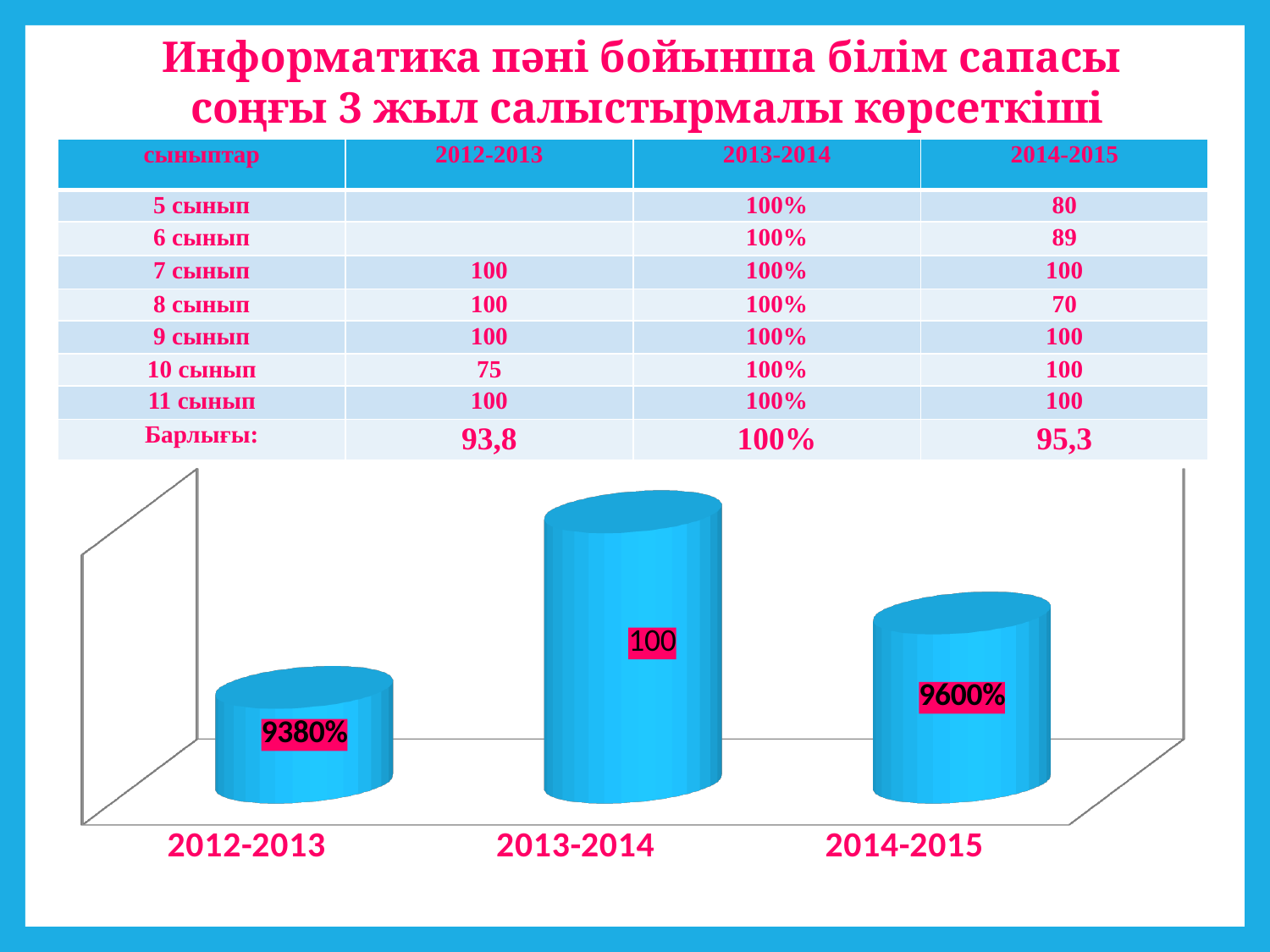
Which category has the shortest bar on the chart? 2012-2013 Do the bars rise or fall from 2013-2014 to 2014-2015? fall What are the category labels along the x axis of the chart, from left to right? 2012-2013, 2013-2014, 2014-2015 Which bar is taller, 2012-2013 or 2014-2015? 2014-2015 Which category has the tallest bar on the chart? 2013-2014 How many categories are plotted on the chart? 3 Which bar is taller, 2013-2014 or 2014-2015? 2013-2014 What colour are the bars on the chart? blue What kind of chart is shown on the slide? bar chart What is the data label shown on the bar for 2012-2013? 9380% What is the data label shown on the bar for 2014-2015? 9600% What is the data label shown on the bar for 2013-2014? 100